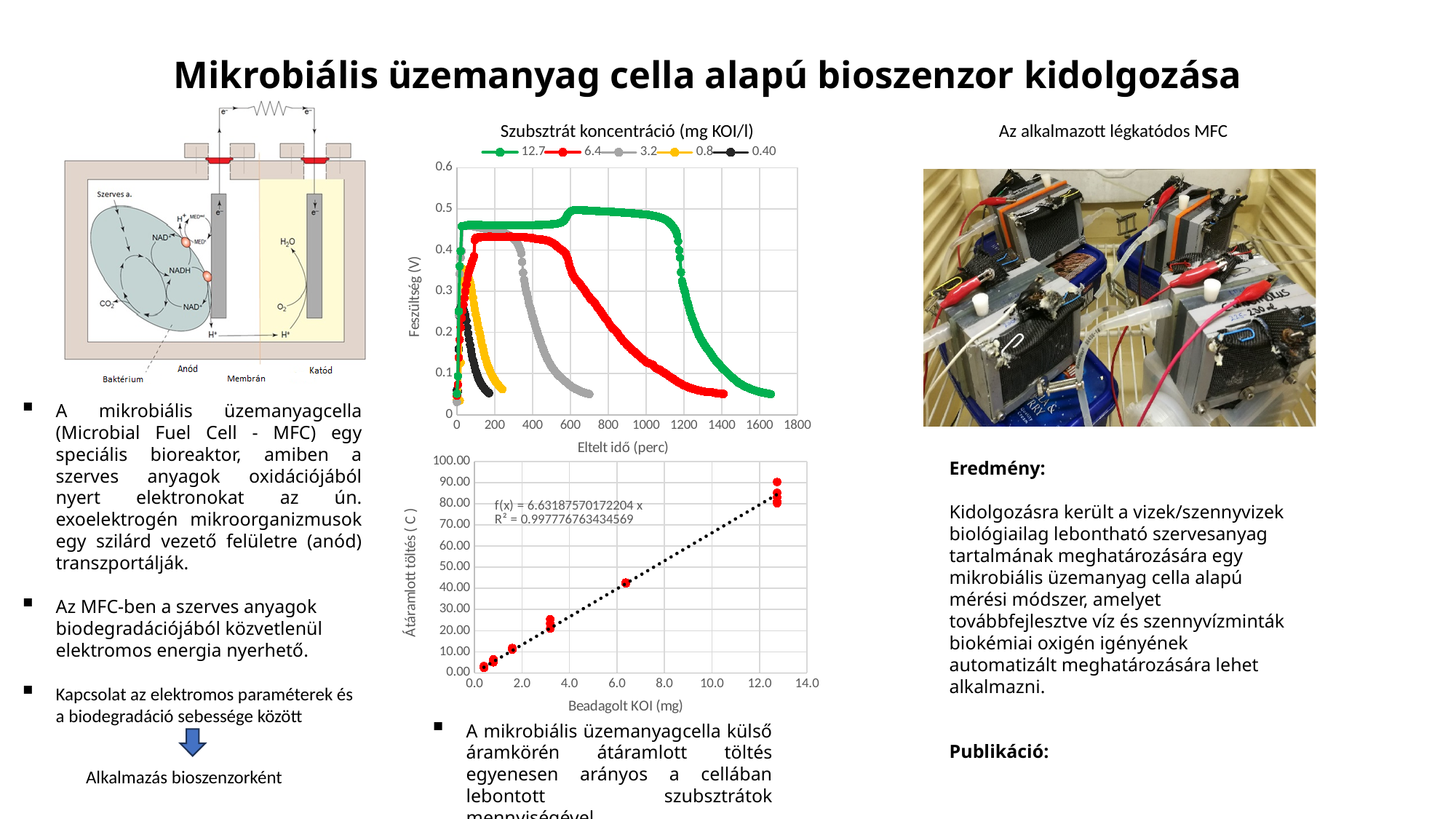
On the bottom chart, what is the label of the horizontal axis? Beadagolt KOI (mg) On the top chart, which series extends to the largest elapsed time (Eltelt idő)? 12.7 On the bottom chart, what is the R² value shown for the trendline? 0.997776763434569 On the bottom chart, does the transferred charge (Átáramlott töltés) rise or fall as Beadagolt KOI increases? rise On the top chart, which series reaches the highest voltage? 12.7 On the top chart, does the voltage of the 6.4 series rise or fall between 600 and 1400 minutes? fall On the top chart titled 'Szubsztrát koncentráció (mg KOI/l)', what kind of chart is it? line chart On the top chart, is the voltage of the 12.7 series at 800 minutes greater or less than 0.4? greater On the top chart, what is the label of the vertical axis? Feszültség (V) On the top chart, is the voltage of the 6.4 series at 1000 minutes greater or less than 0.2? less On the top chart titled 'Szubsztrát koncentráció (mg KOI/l)', how many series does the legend list? 5 On the bottom chart (Átáramlott töltés vs Beadagolt KOI), what kind of chart is it? scatter chart